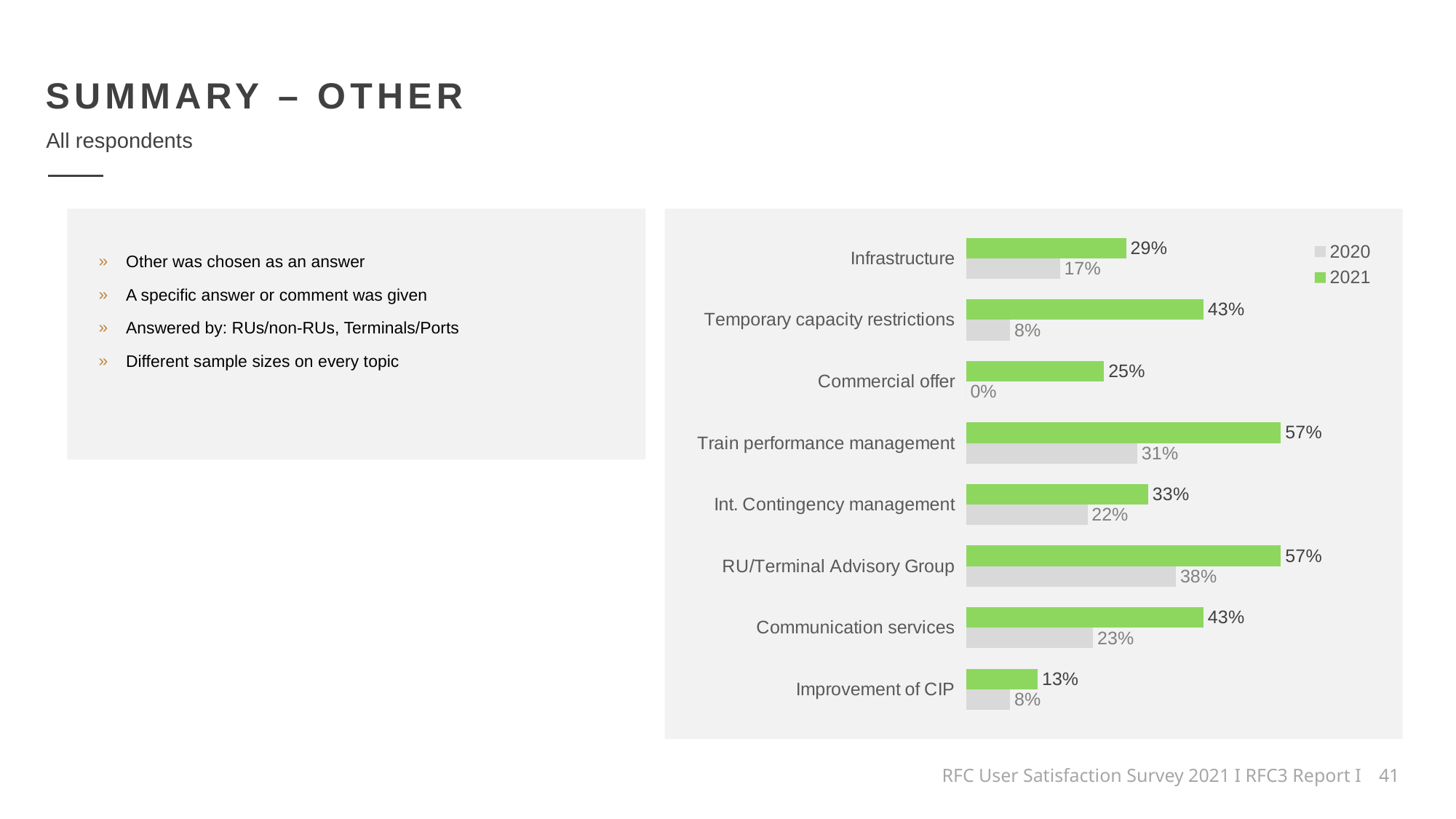
Which colour represents the 2021 series in the chart? Green Which category has the lowest 2021 value? Improvement of CIP What is the 2020 value for Commercial offer? 0% How many series does the legend list? 2 What is the 2020 value for Infrastructure? 17% How many categories are shown in the chart? 8 Which is larger: the 2021 value for Communication services or the 2021 value for Int. Contingency management? Communication services What is the 2021 value for Train performance management? 57% What is the difference between the 2021 and 2020 values for Temporary capacity restrictions? 35 percentage points What kind of chart is shown on the slide? Bar chart Which category has the highest 2020 value? RU/Terminal Advisory Group What is the 2021 value for Improvement of CIP? 13%